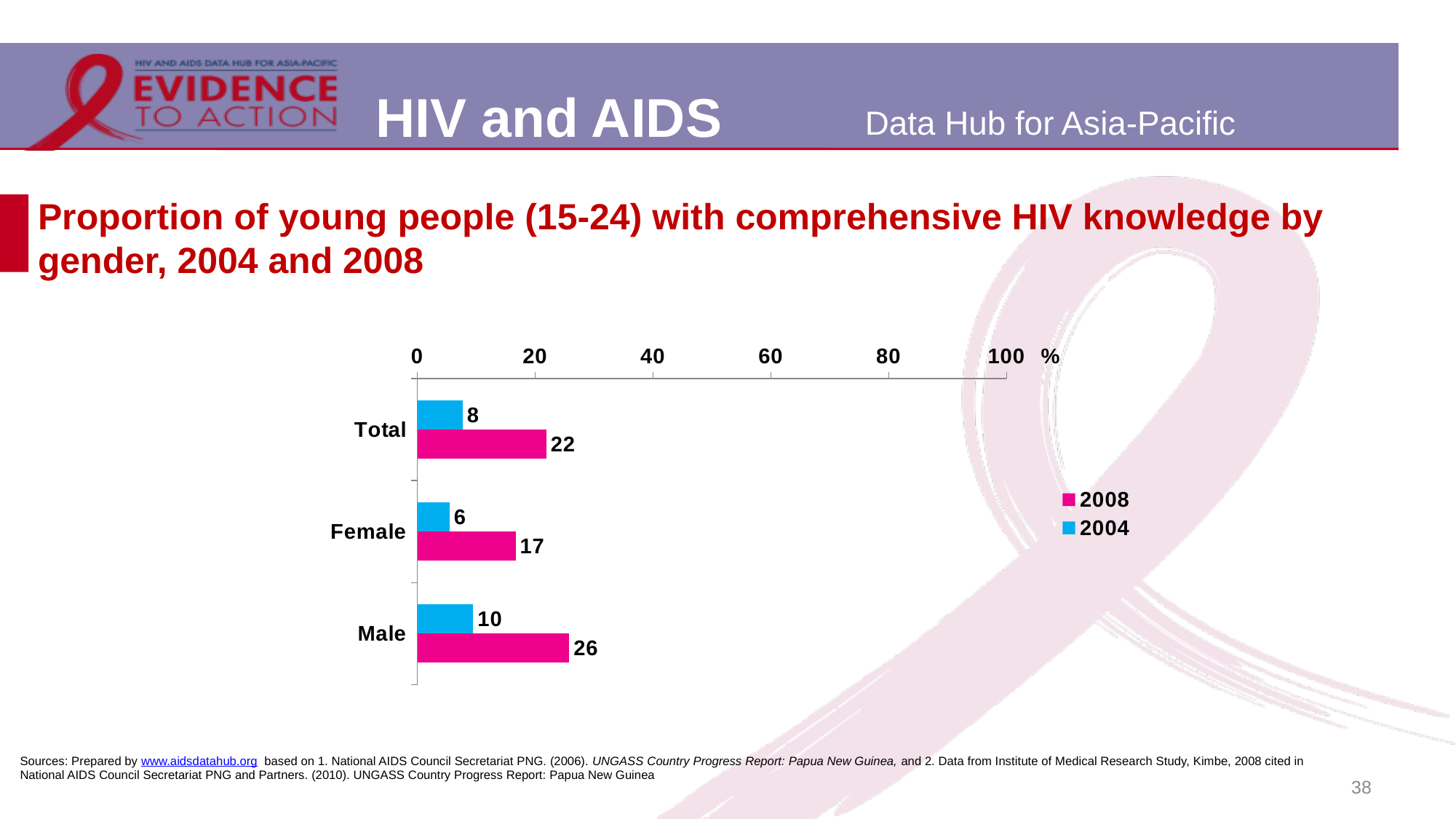
How many categories are shown on the chart? 3 Which category has the lowest value in 2004? Female How many series does the legend list? 2 Which category has the highest value in 2008? Male Which is larger, the Male value in 2004 or the Female value in 2004? Male What is the value for Female in 2004? 6 Is the value for Male in 2008 greater or less than 20? greater What is the difference between the Male and Female values in 2008? 9 What is the value for Male in 2008? 26 What is the difference between the 2008 and 2004 values for Total? 14 What is the value for Total in 2008? 22 What kind of chart is shown on the slide? Bar chart